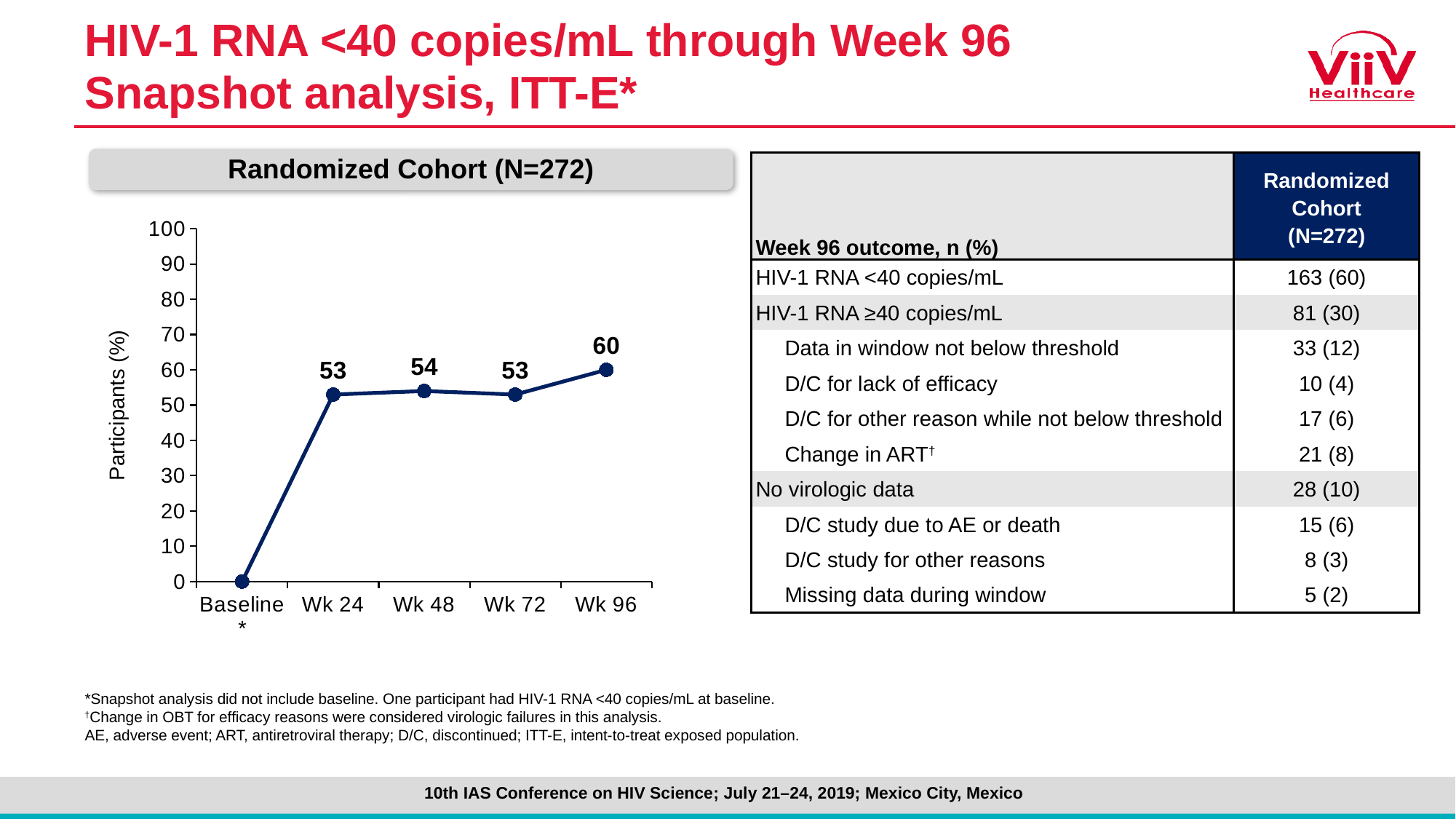
What is the value for Baseline in the line chart? 0 At which time point is the plotted value lowest? Baseline Does the plotted value rise or fall from Wk 72 to Wk 96? Rise What is the difference between the values at Wk 96 and Wk 72? 7 What is the value for Wk 48 in the line chart? 54 What is the value for Wk 24 in the line chart? 53 How many time points are plotted on the x axis of the line chart? 5 What type of chart is shown on the slide? Line chart What is the label of the y axis of the line chart? Participants (%) What is the value for Wk 96 in the line chart? 60 Which is larger, the value at Wk 48 or the value at Wk 72? Wk 48 At which time point is the plotted value highest? Wk 96